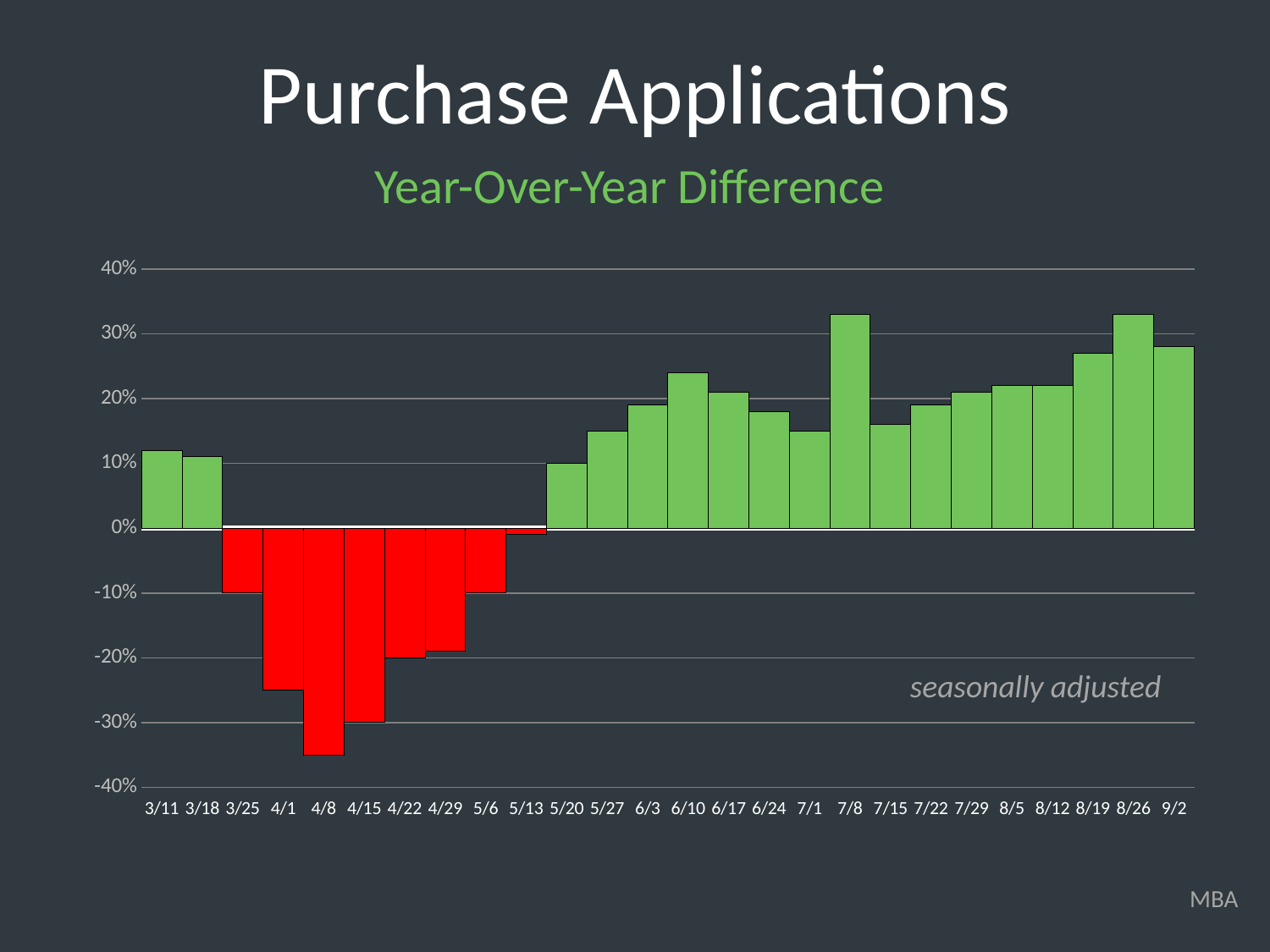
Do the values rise or fall from 5/13 to 6/10? rise What is the year-over-year difference for 4/15? -30% What is the year-over-year difference for 4/22? -20% What kind of chart is shown on the slide? bar chart How many dates are shown along the x axis of the chart? 26 How many bars on the chart are red (negative values)? 8 What is the year-over-year difference for 5/20? 10% Is the value for 6/10 greater or less than 20%? greater Is the value for 4/8 greater or less than -30%? less Which date has the lowest year-over-year difference? 4/8 Is the value for 7/8 greater or less than 30%? greater Which has the larger year-over-year difference, 6/10 or 6/17? 6/10